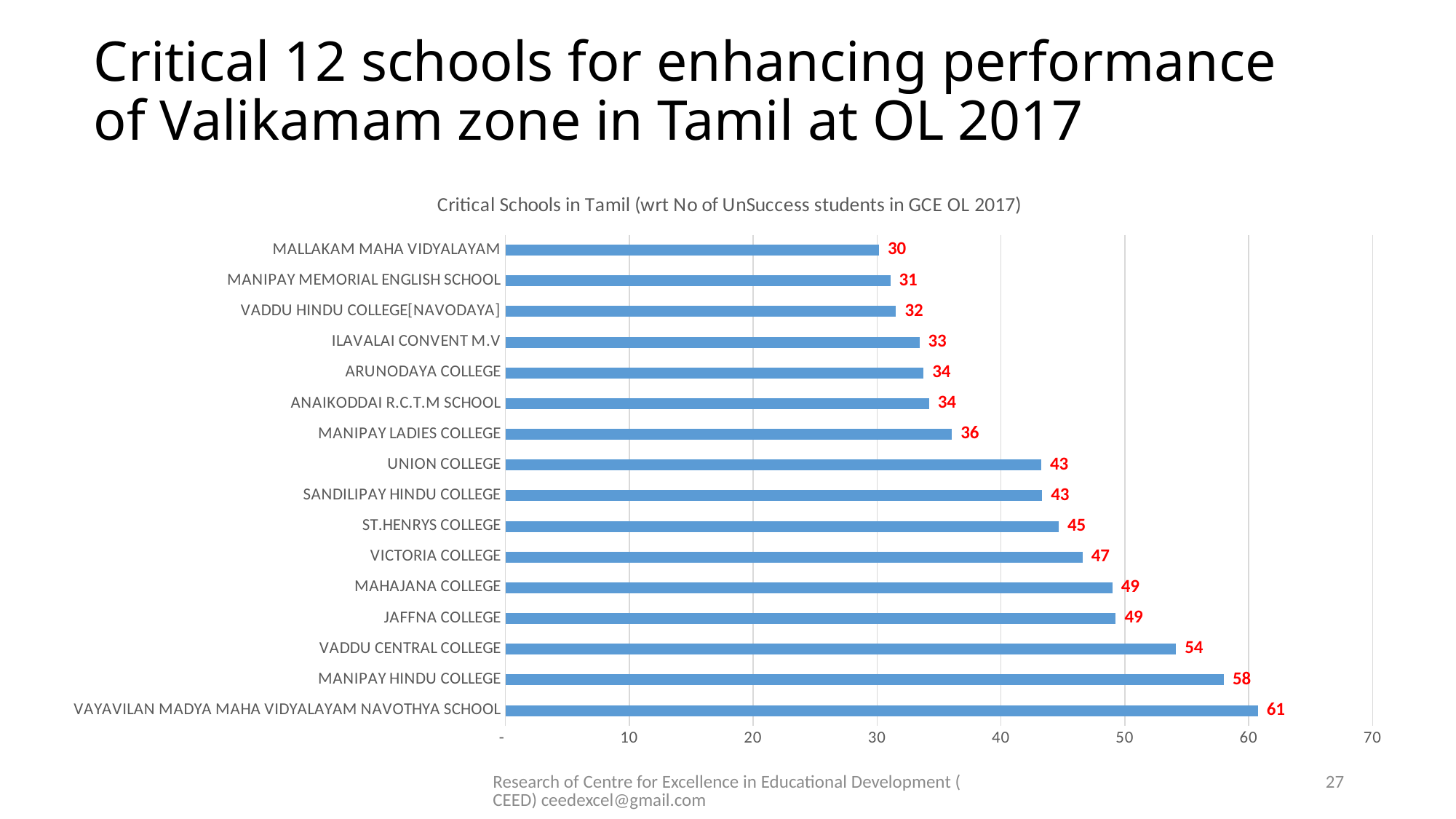
Which has a larger value, ST.HENRYS COLLEGE or MANIPAY LADIES COLLEGE? ST.HENRYS COLLEGE What is the value for UNION COLLEGE? 43 What colour are the bars in the chart? Blue What kind of chart is shown on the slide? Bar chart Which school has the highest value? VAYAVILAN MADYA MAHA VIDYALAYAM NAVOTHYA SCHOOL What is the value for ILAVALAI CONVENT M.V? 33 Which school has the lowest value? MALLAKAM MAHA VIDYALAYAM What is the title of the chart? Critical Schools in Tamil (wrt No of UnSuccess students in GCE OL 2017) Is the value for MAHAJANA COLLEGE greater or less than 40? greater What is the difference between the values for VADDU CENTRAL COLLEGE and VICTORIA COLLEGE? 7 How many schools are shown in the chart? 16 What is the value for MANIPAY HINDU COLLEGE? 58